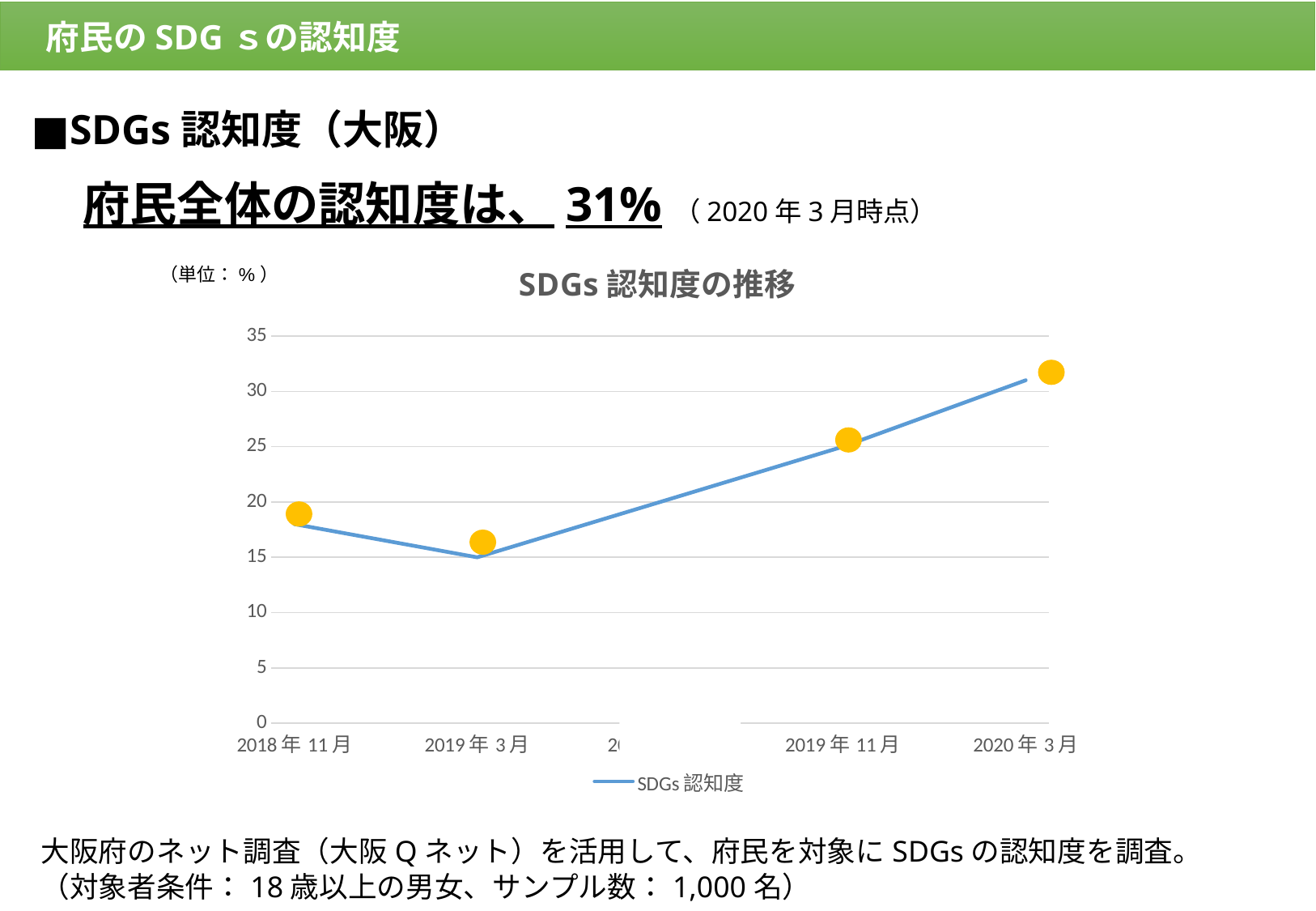
What type of chart is shown on the slide? line chart Which is larger, the value for 2018年11月 or the value for 2019年3月? 2018年11月 Is the value for 2018年11月 greater or less than 20? less Do the values rise or fall from 2019年3月 to 2020年3月? rise Which time point has the highest SDGs awareness value? 2020年3月 What is the title of the chart? SDGs 認知度の推移 Is the value for 2019年11月 greater or less than 20? greater Which time point has the lowest SDGs awareness value? 2019年3月 How many data points are plotted on the line? 4 What is the SDGs awareness value for 2020年3月? 31% What is the name of the series shown in the legend? SDGs 認知度 How many series does the chart legend list? 1